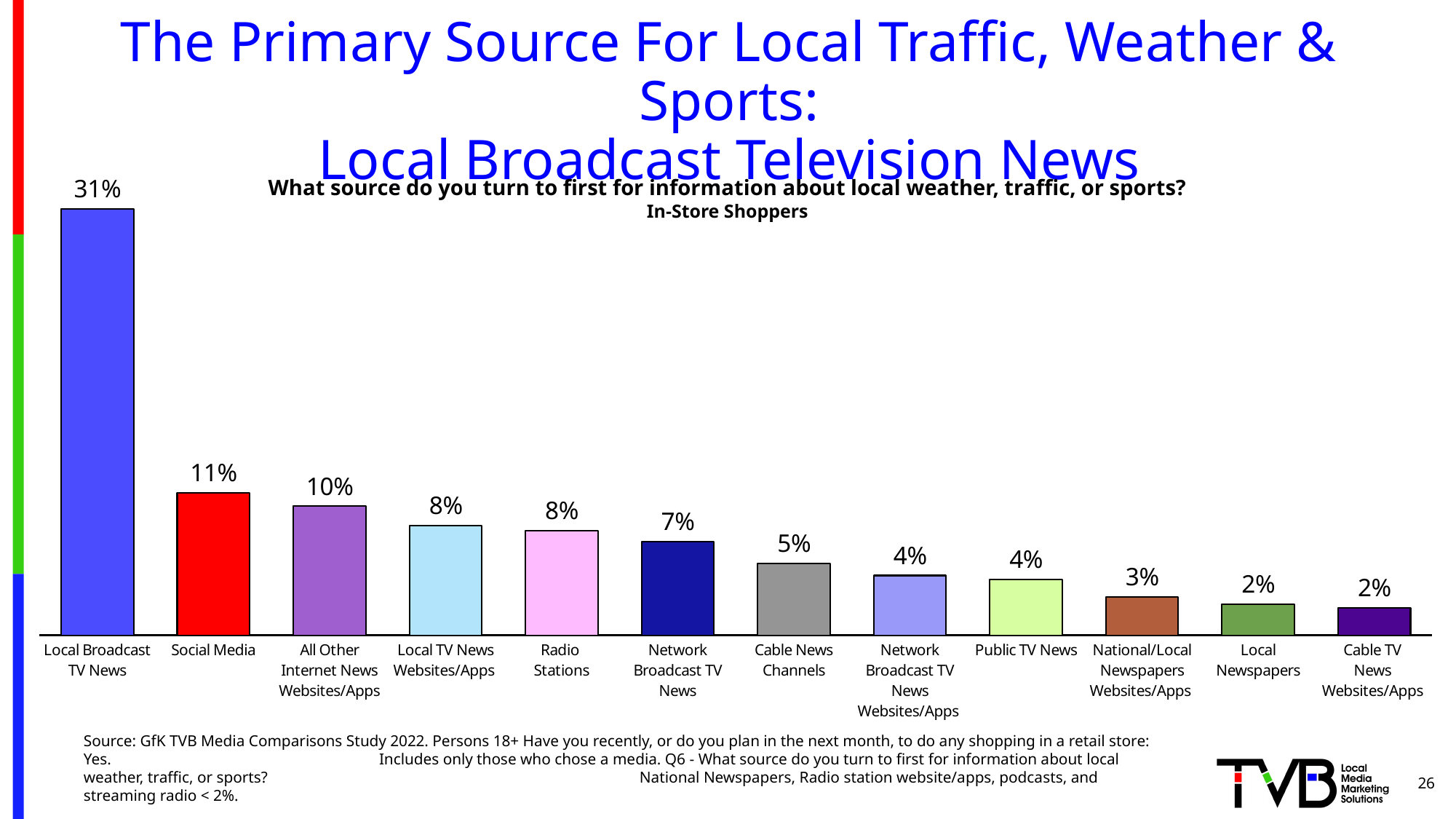
Which source has the highest percentage in the chart? Local Broadcast TV News Do the values rise or fall moving from left to right across the chart? Fall Which is larger, the value for Radio Stations or the value for Public TV News? Radio Stations What type of chart is shown on the slide? Bar chart What is the value shown for Cable News Channels? 5% What is the value shown for National/Local Newspapers Websites/Apps? 3% How many sources (categories) are shown in the chart? 12 What is the difference between the values for Local Broadcast TV News and Social Media? 20% Which group of respondents does the chart describe, according to the subtitle? In-Store Shoppers What is the value shown for Social Media? 11% What is the difference between the values for All Other Internet News Websites/Apps and Network Broadcast TV News? 3% What percentage of in-store shoppers turn first to Local Broadcast TV News for local weather, traffic, or sports? 31%